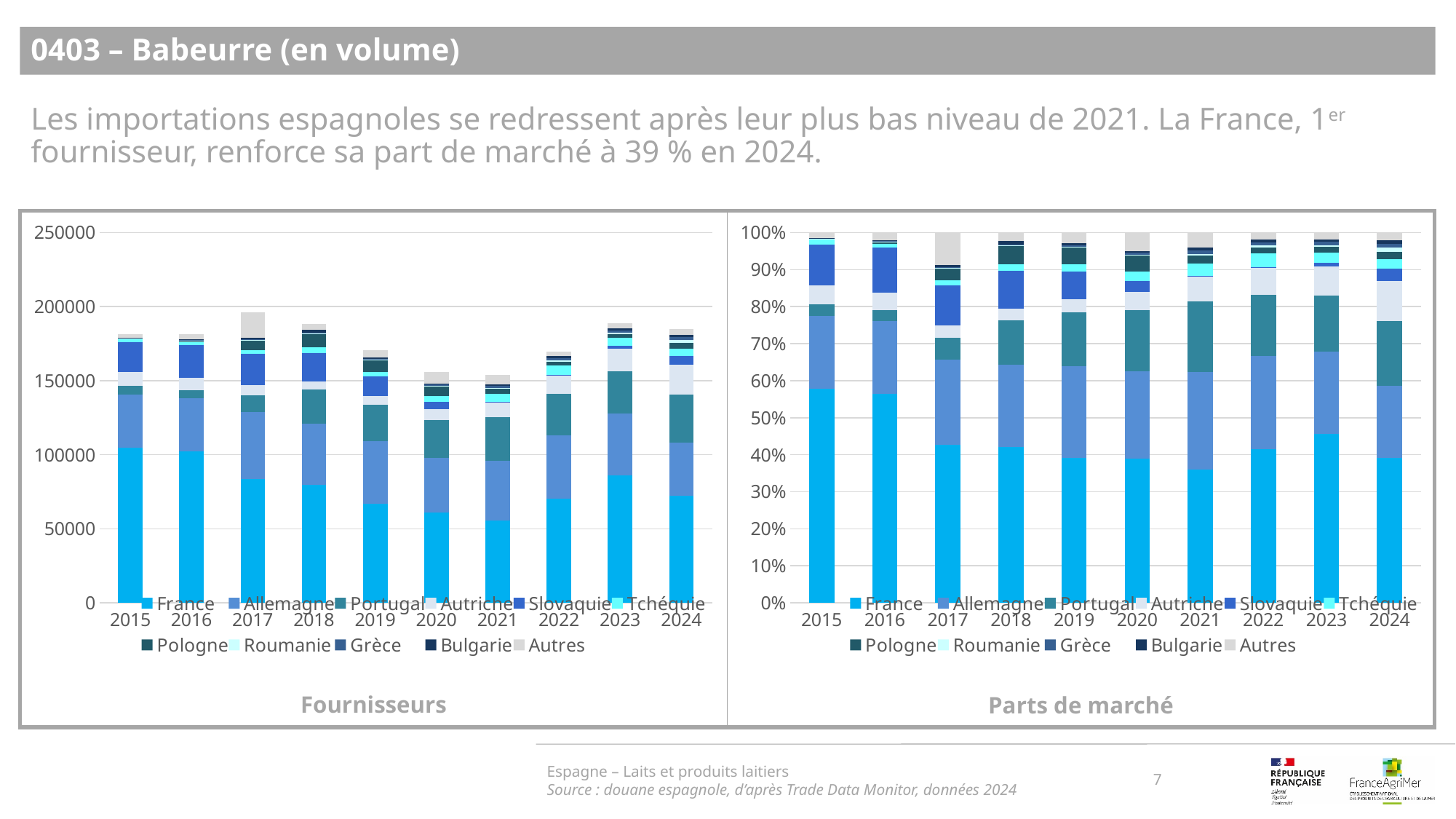
In the 'Parts de marché' chart, is the share of France in 2015 greater or less than 50%? greater In the 'Parts de marché' chart, is the share of France in 2021 greater or less than 40%? less In the 'Fournisseurs' chart, is the value for France in 2015 greater or less than 100000? greater In the 'Fournisseurs' chart, which year has the highest total bar? 2017 In the 'Fournisseurs' chart, is the value for France larger in 2015 or in 2024? 2015 How many years are shown on the x axis of the 'Parts de marché' chart? 10 In the 'Fournisseurs' chart, which year has the lowest total bar? 2021 Which series is listed first in the legend of the 'Parts de marché' chart? France In the 'Parts de marché' chart, is the share of France larger in 2015 or in 2023? 2015 How many series does the legend of the 'Fournisseurs' chart list? 11 What kind of chart is the 'Fournisseurs' chart on the left? stacked bar chart